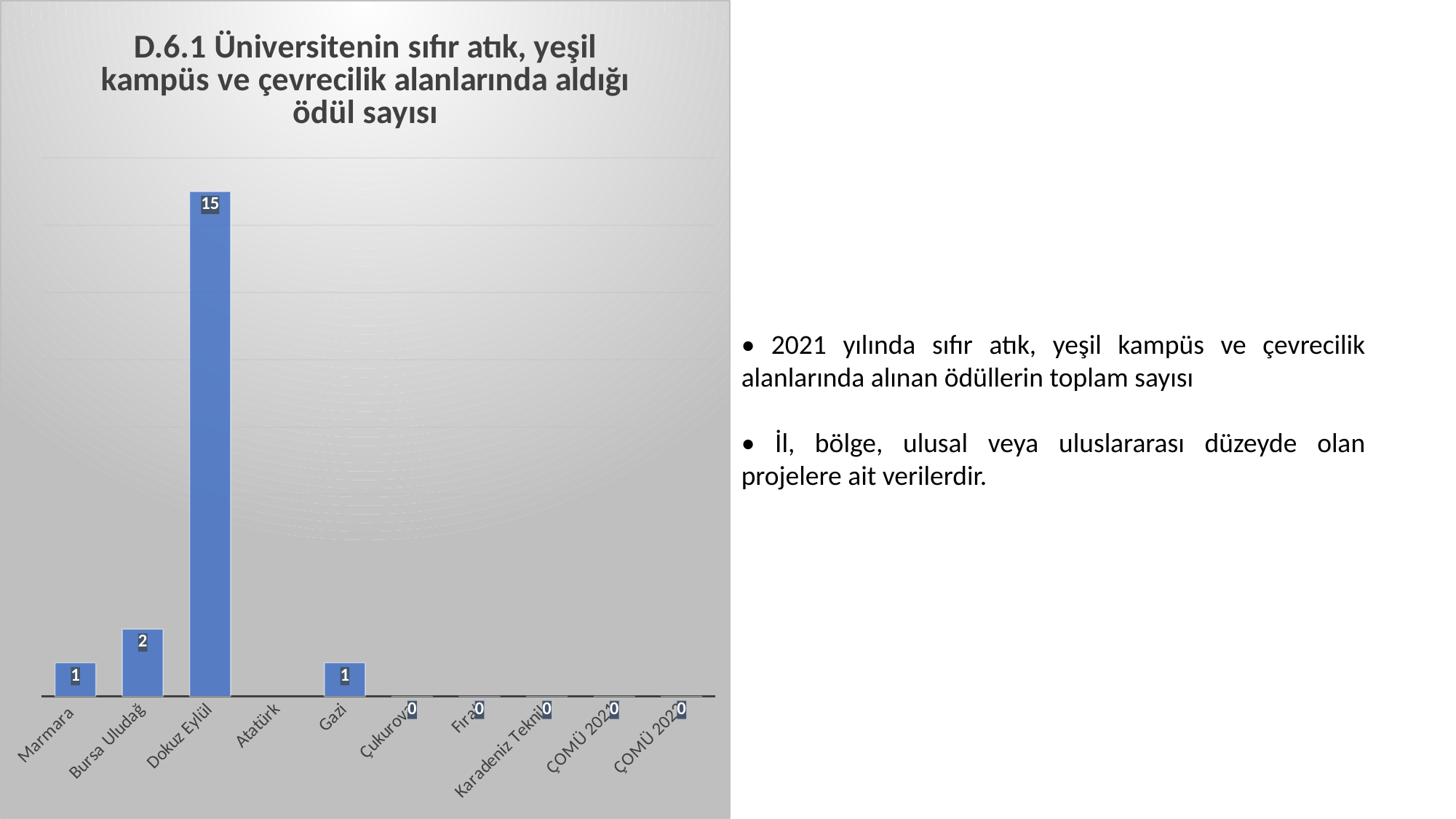
What is the difference between the values for Dokuz Eylül and Bursa Uludağ? 13 How many categories are shown on the x axis? 10 What kind of chart is shown on the slide? Bar chart What is the value for Karadeniz Teknik? 0 Which university has the highest number of awards? Dokuz Eylül What is the value for Dokuz Eylül? 15 What is the title of the chart? D.6.1 Üniversitenin sıfır atık, yeşil kampüs ve çevrecilik alanlarında aldığı ödül sayısı Which is larger, the value for Bursa Uludağ or the value for Gazi? Bursa Uludağ What is the value for Bursa Uludağ? 2 What is the value for Marmara? 1 What is the value for Gazi? 1 What is the difference between the values for Marmara and Gazi? 0